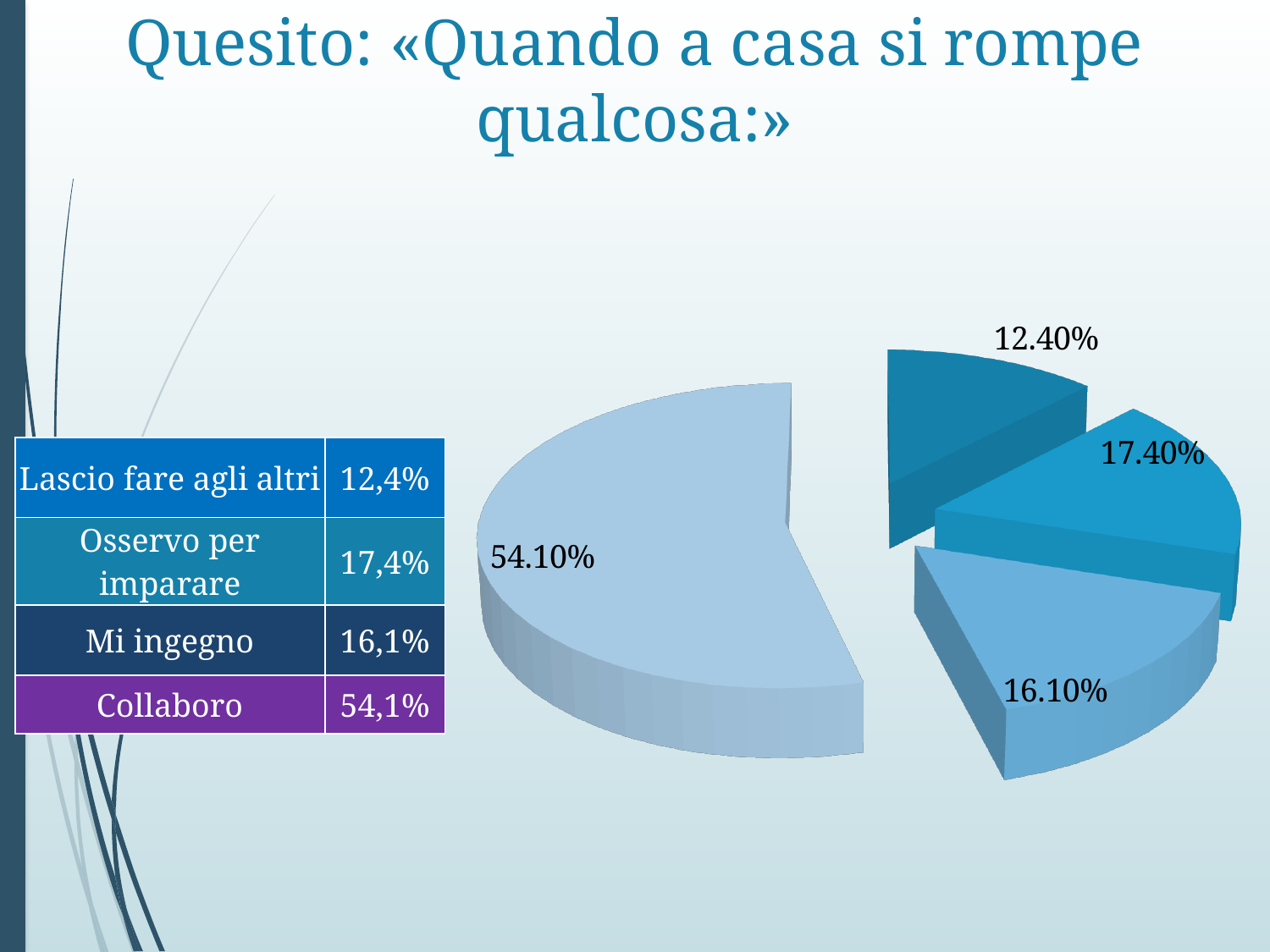
How many slices does the pie chart have? 4 According to the pie chart's data label, what share corresponds to 'Osservo per imparare'? 17.40% Which category has the smallest share in the pie chart? Lascio fare agli altri Which slice is larger: the one labelled 17.40% or the one labelled 16.10%? 17.40% Which category has the largest share in the pie chart? Collaboro According to the pie chart's data label, what share corresponds to 'Lascio fare agli altri'? 12.40% According to the pie chart's data label, what share corresponds to 'Collaboro'? 54.10% What is the difference in percentage points between the 54.10% slice and the 16.10% slice? 38 percentage points What kind of chart is shown on the slide? pie chart What is the data label on the largest slice of the pie chart? 54.10% What is the data label on the smallest slice of the pie chart? 12.40% According to the pie chart's data label, what share corresponds to 'Mi ingegno'? 16.10%